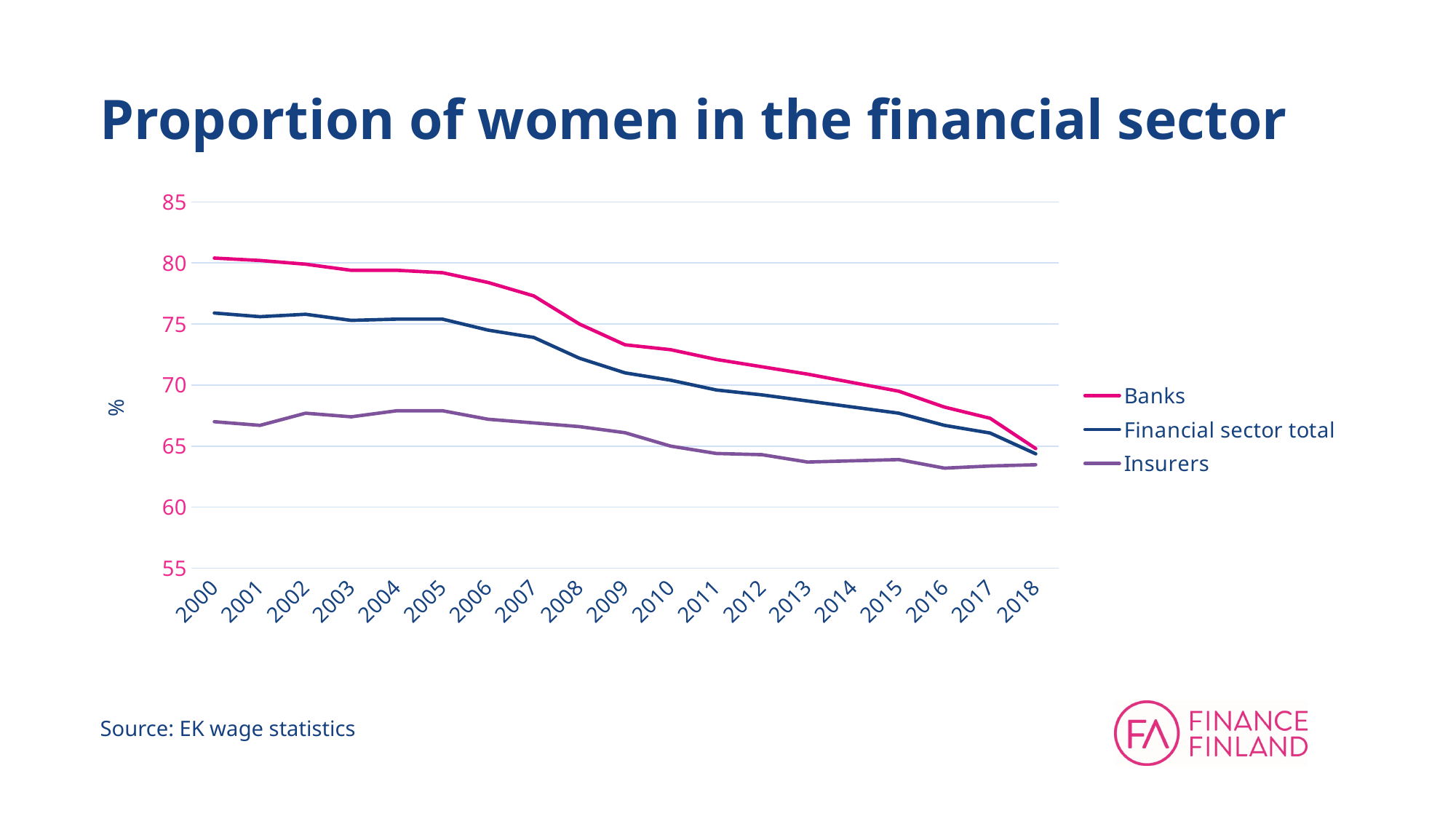
Do the values for Banks rise or fall from 2000 to 2018? fall What is the source given for the chart? EK wage statistics Is the value for Insurers in 2018 greater or less than 65? less Which series has the highest value in 2005? Banks Is the value for Banks in 2009 greater or less than 75? less Is the value for Financial sector total in 2000 greater or less than 70? greater In 2010, which is larger: the value for Banks or the value for Insurers? Banks Which series has the lowest value in 2000? Insurers How many series does the legend list? 3 What kind of chart is shown on the slide? line chart How many years are shown on the x axis? 19